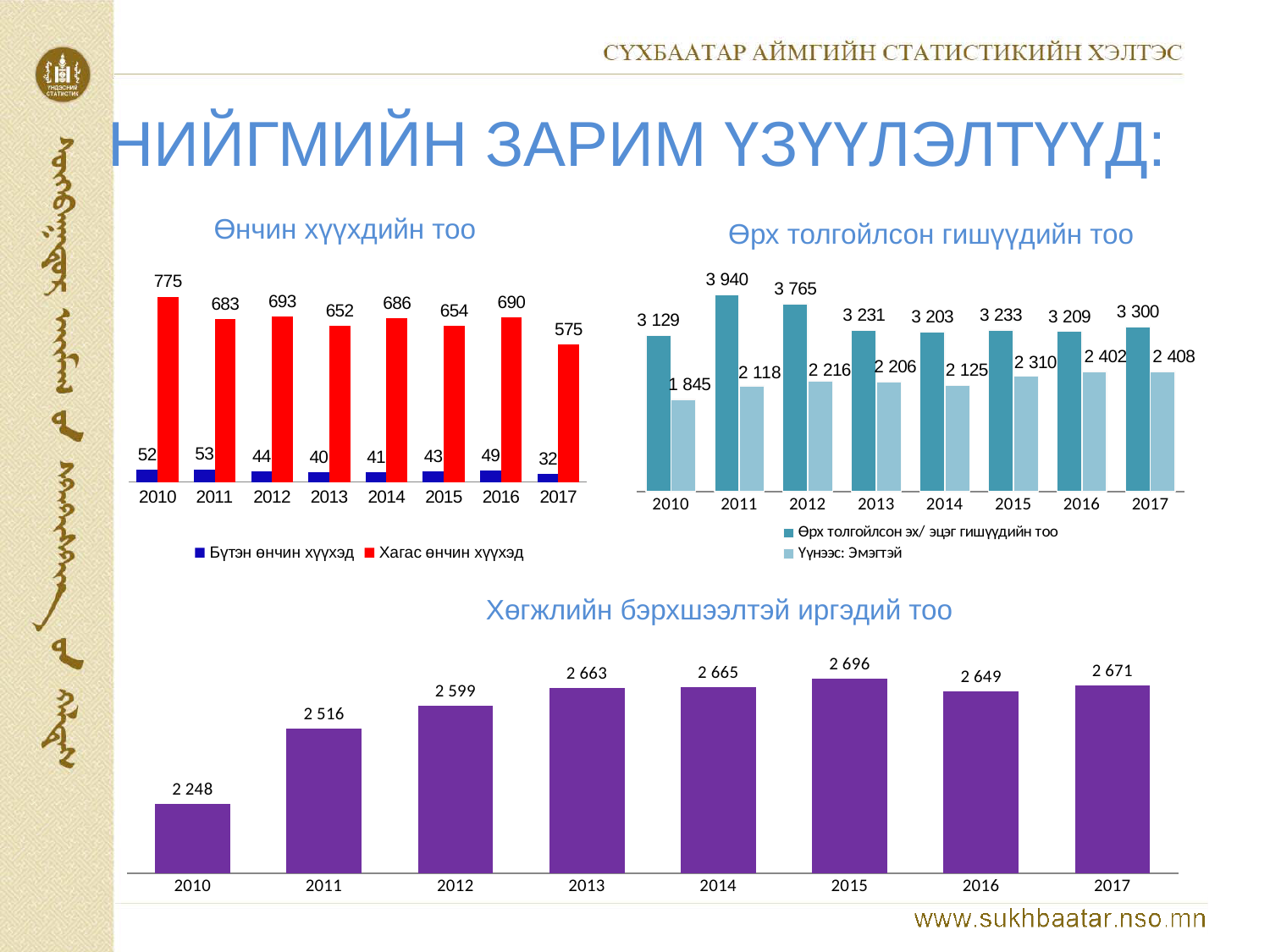
In the chart titled "Өрх толгойлсон гишүүдийн тоо", which year has the highest value for Үүнээс: Эмэгтэй? 2017 In the chart titled "Өрх толгойлсон гишүүдийн тоо", what is the value for Өрх толгойлсон эх/ эцэг гишүүдийн тоо in 2011? 3 940 In the chart titled "Өнчин хүүхдийн тоо", what is the value for Хагас өнчин хүүхэд in 2010? 775 In the chart titled "Хөгжлийн бэрхшээлтэй иргэдий тоо", how many years are shown on the x axis? 8 What kind of chart is the chart titled "Хөгжлийн бэрхшээлтэй иргэдий тоо"? Bar chart In the chart titled "Өрх толгойлсон гишүүдийн тоо", is the Үүнээс: Эмэгтэй value larger in 2012 or in 2014? 2012 In the chart titled "Хөгжлийн бэрхшээлтэй иргэдий тоо", what is the value for 2013? 2 663 In the chart titled "Өнчин хүүхдийн тоо", which year has the lowest value for Бүтэн өнчин хүүхэд? 2017 In the chart titled "Хөгжлийн бэрхшээлтэй иргэдий тоо", which year has the highest value? 2015 In the chart titled "Өрх толгойлсон гишүүдийн тоо", what is the difference between the Өрх толгойлсон эх/ эцэг гишүүдийн тоо value and the Үүнээс: Эмэгтэй value in 2010? 1 284 In the chart titled "Өнчин хүүхдийн тоо", how many series does the legend list? 2 In the chart titled "Өнчин хүүхдийн тоо", what is the difference between the Хагас өнчин хүүхэд values for 2010 and 2017? 200